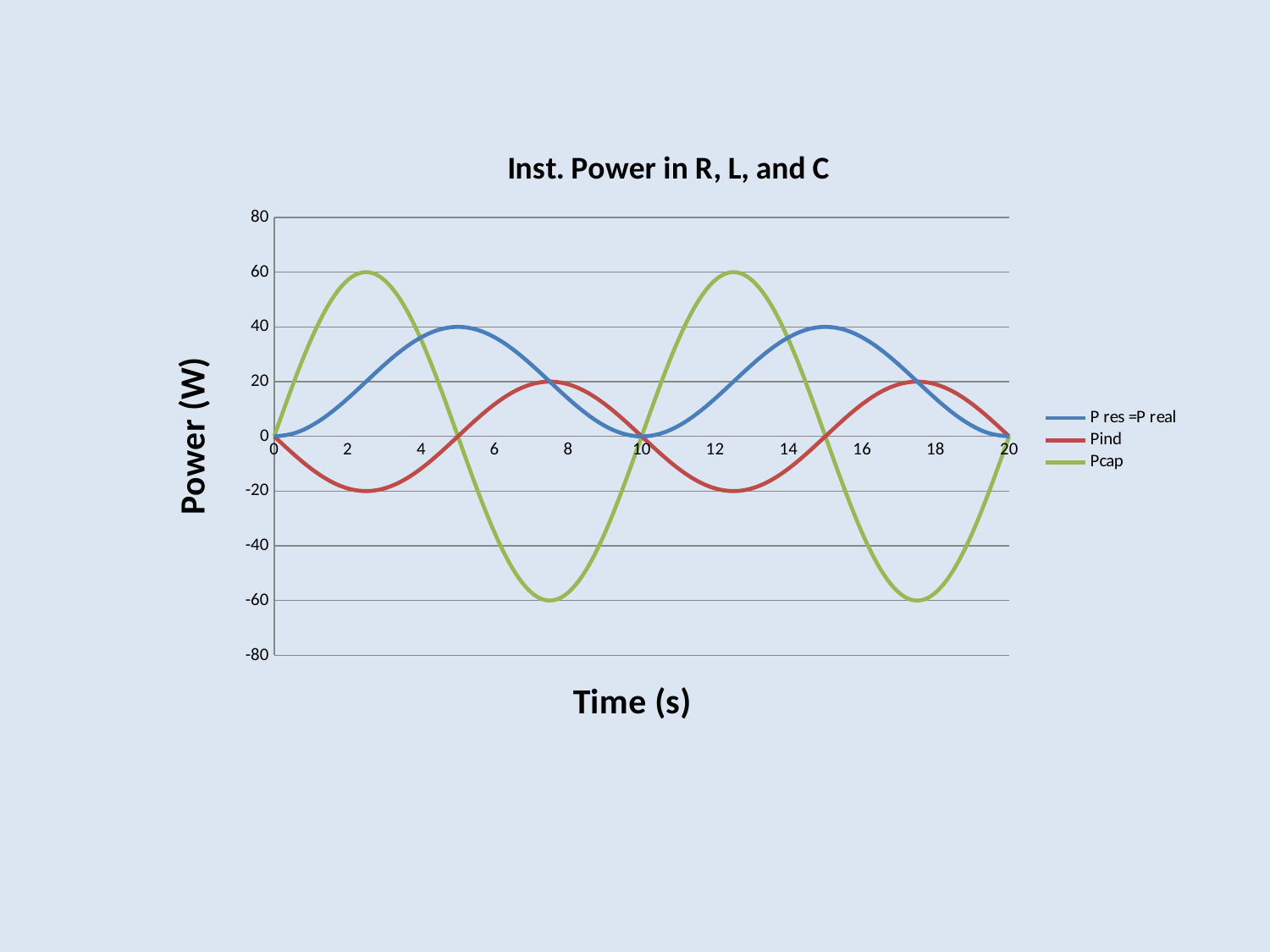
What is the title of the chart? Inst. Power in R, L, and C Which series has the smallest peak value? Pind How many series does the legend list? 3 What is the maximum value reached by the Pcap series? 60 What kind of chart is shown on the slide? line chart What is the peak value of the P res =P real series? 40 Which series reaches the highest peak value? Pcap What is the minimum value reached by the Pcap series? -60 What is the difference between the peak value of Pcap and the peak value of Pind? 40 What is the lowest value reached by the Pind series? -20 Is the value of P res =P real at time 5 greater or less than 20? greater What is the label of the y axis? Power (W)